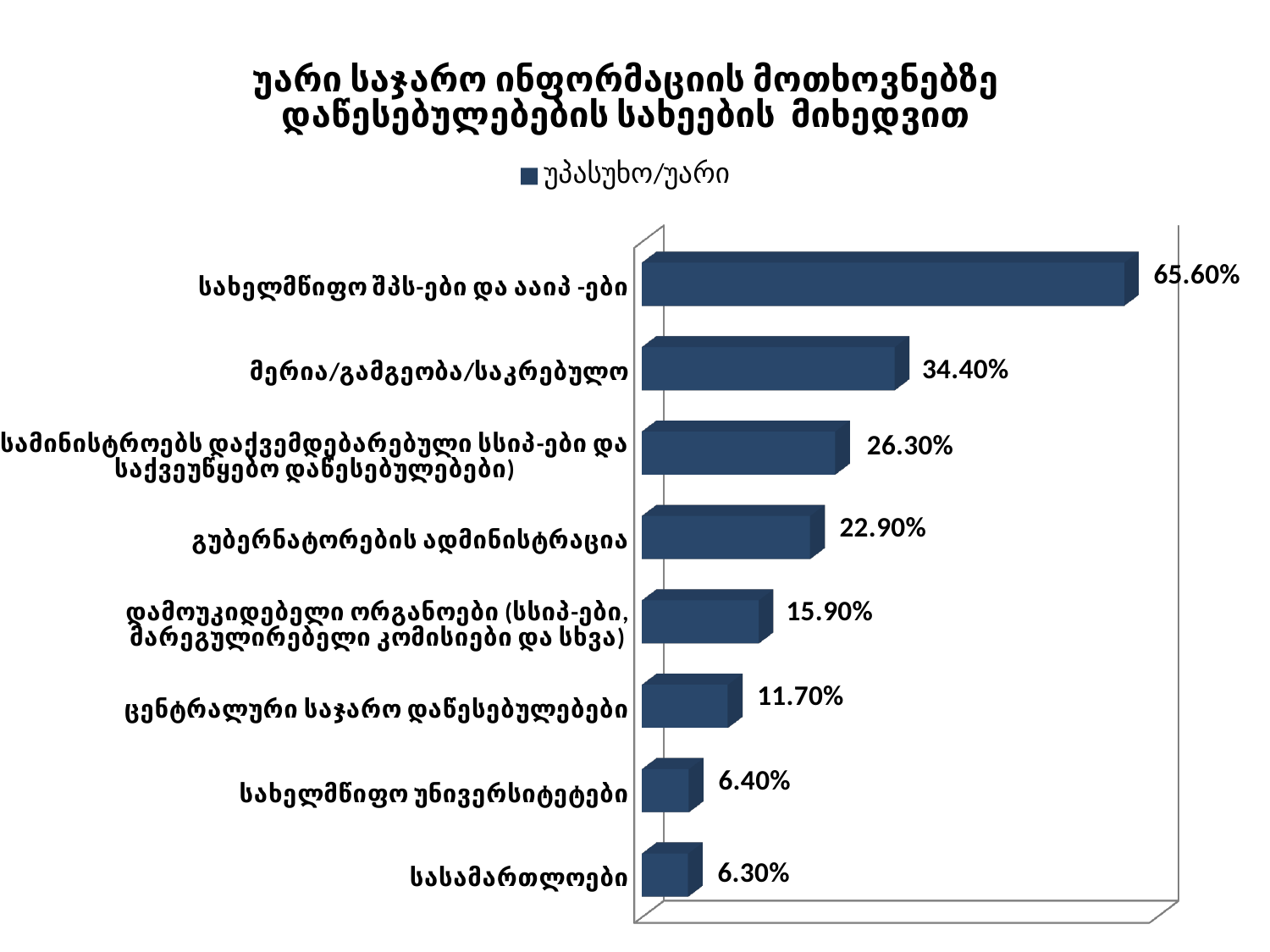
What type of chart is shown on the slide? bar chart What is the value for მერია/გამგეობა/საკრებულო? 34.40% Which category has the lowest value? სასამართლოები How many categories are plotted in the chart? 8 Which is larger: the value for გუბერნატორების ადმინისტრაცია or the value for ცენტრალური საჯარო დაწესებულებები? გუბერნატორების ადმინისტრაცია How many series does the legend list? 1 Which category has the highest value? სახელმწიფო შპს-ები და ააიპ -ები What is the value for სახელმწიფო შპს-ები და ააიპ -ები? 65.60% What is the legend entry for the series shown in the chart? უპასუხო/უარი What is the value for გუბერნატორების ადმინისტრაცია? 22.90% What is the value for ცენტრალური საჯარო დაწესებულებები? 11.70% What is the difference between the values for სახელმწიფო შპს-ები და ააიპ -ები and მერია/გამგეობა/საკრებულო? 31.20%